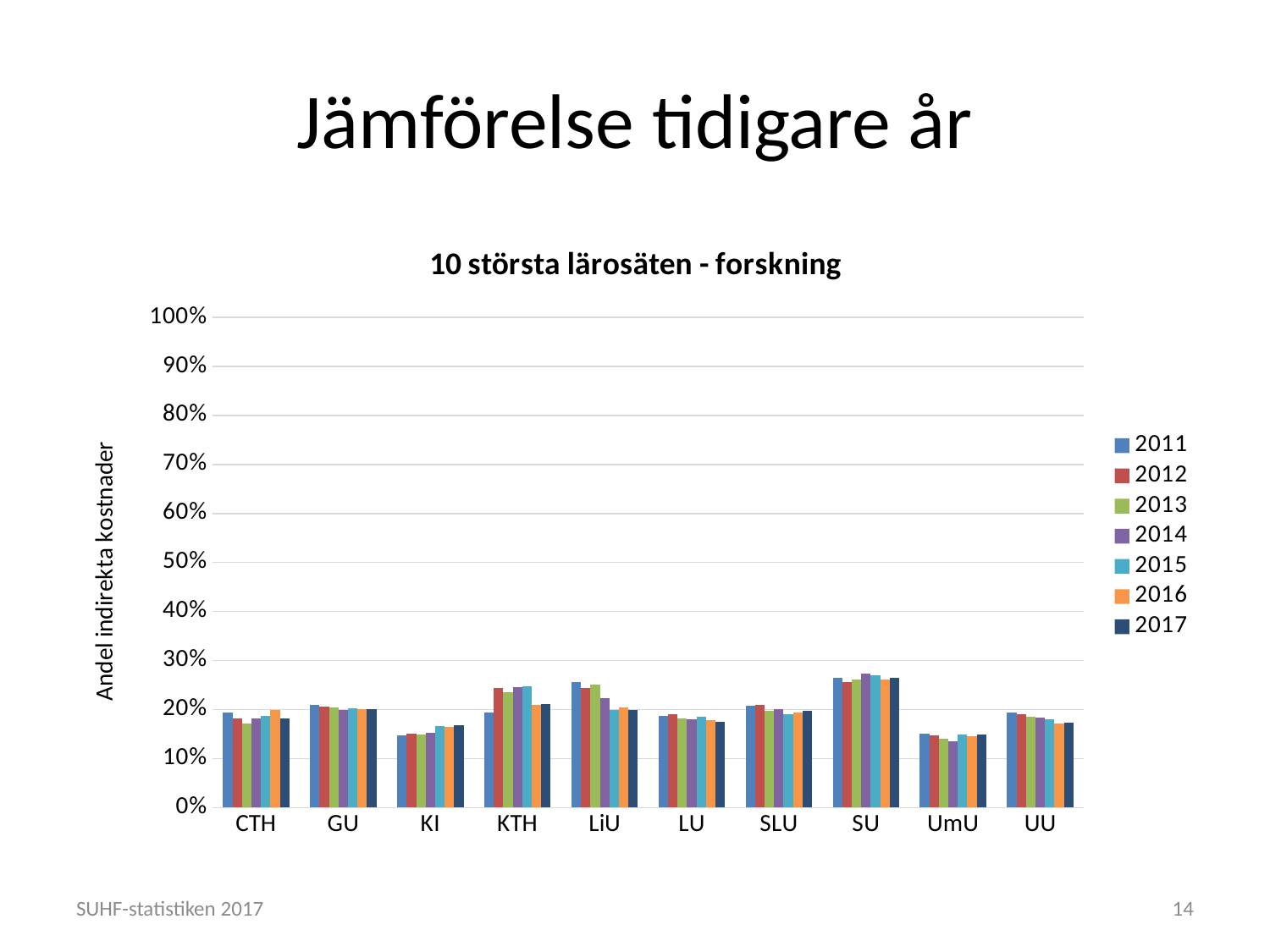
Which is larger, the value for SU in 2011 or the value for UmU in 2011? SU in 2011 How many series does the chart's legend list? 7 What kind of chart is shown on the slide? bar chart Is the value for SU in 2014 greater or less than 20%? greater Which institution has the highest values in the chart? SU Which institution has the lowest value for 2013? UmU Which is larger, the value for LiU in 2011 or the value for LiU in 2017? LiU in 2011 Is the value for KI in 2011 greater or less than 20%? less Is the value for KTH in 2012 greater or less than 20%? greater What is the title of the chart? 10 största lärosäten - forskning How many institutions (categories) are shown on the x axis of the chart? 10